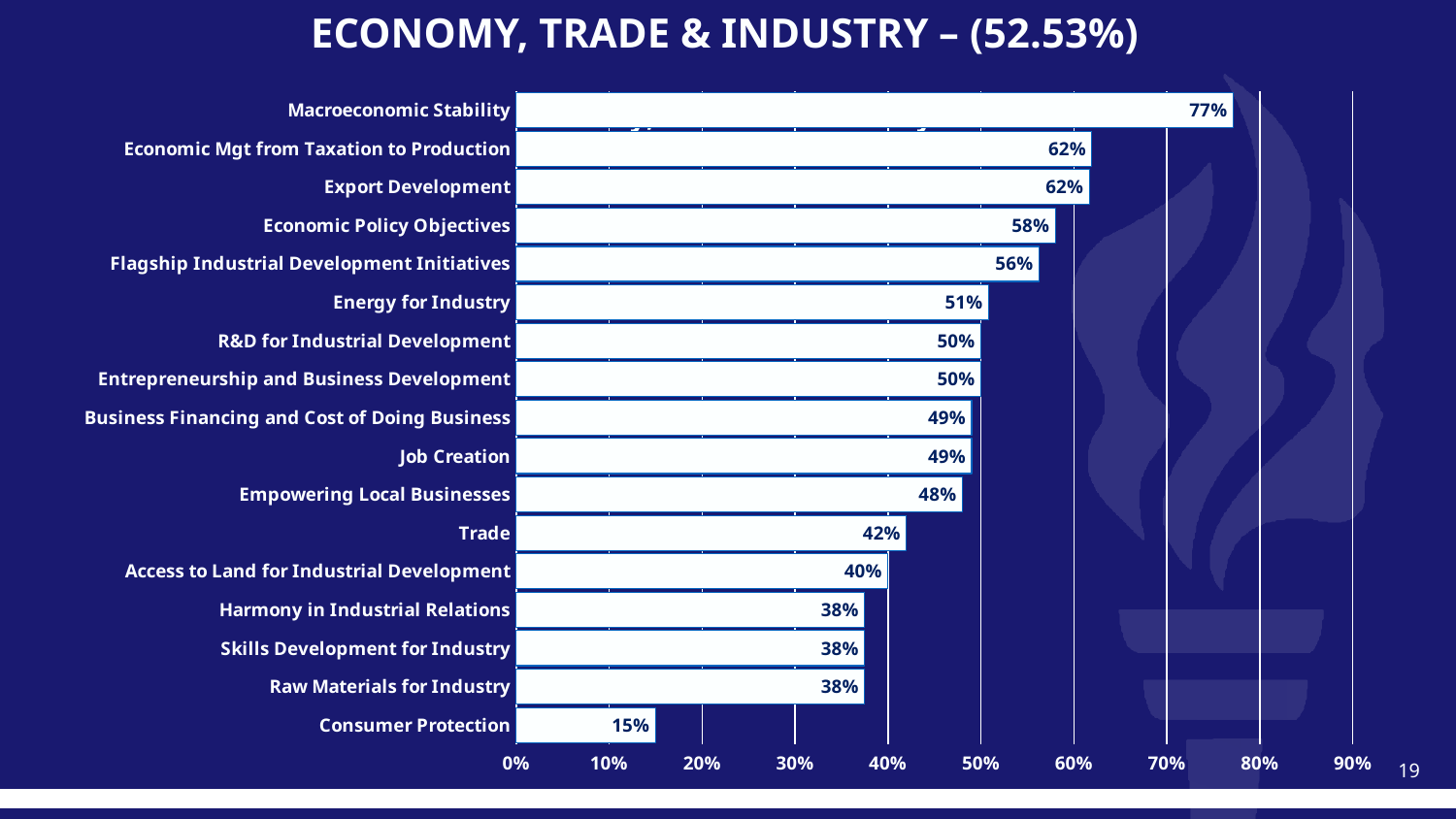
What is the value for Flagship Industrial Development Initiatives? 56% Which category has the highest value? Macroeconomic Stability What is the value for Consumer Protection? 15% What is the value for Trade? 42% Which category has the lowest value? Consumer Protection What is the difference between the values for Macroeconomic Stability and Consumer Protection? 62% Which is larger, the value for Export Development or the value for Access to Land for Industrial Development? Export Development What is the title of the chart? ECONOMY, TRADE & INDUSTRY – (52.53%) What is the difference between the values for Economic Policy Objectives and Energy for Industry? 7% What is the value for Macroeconomic Stability? 77% How many categories are shown in the chart? 17 What kind of chart is shown on the slide? Bar chart